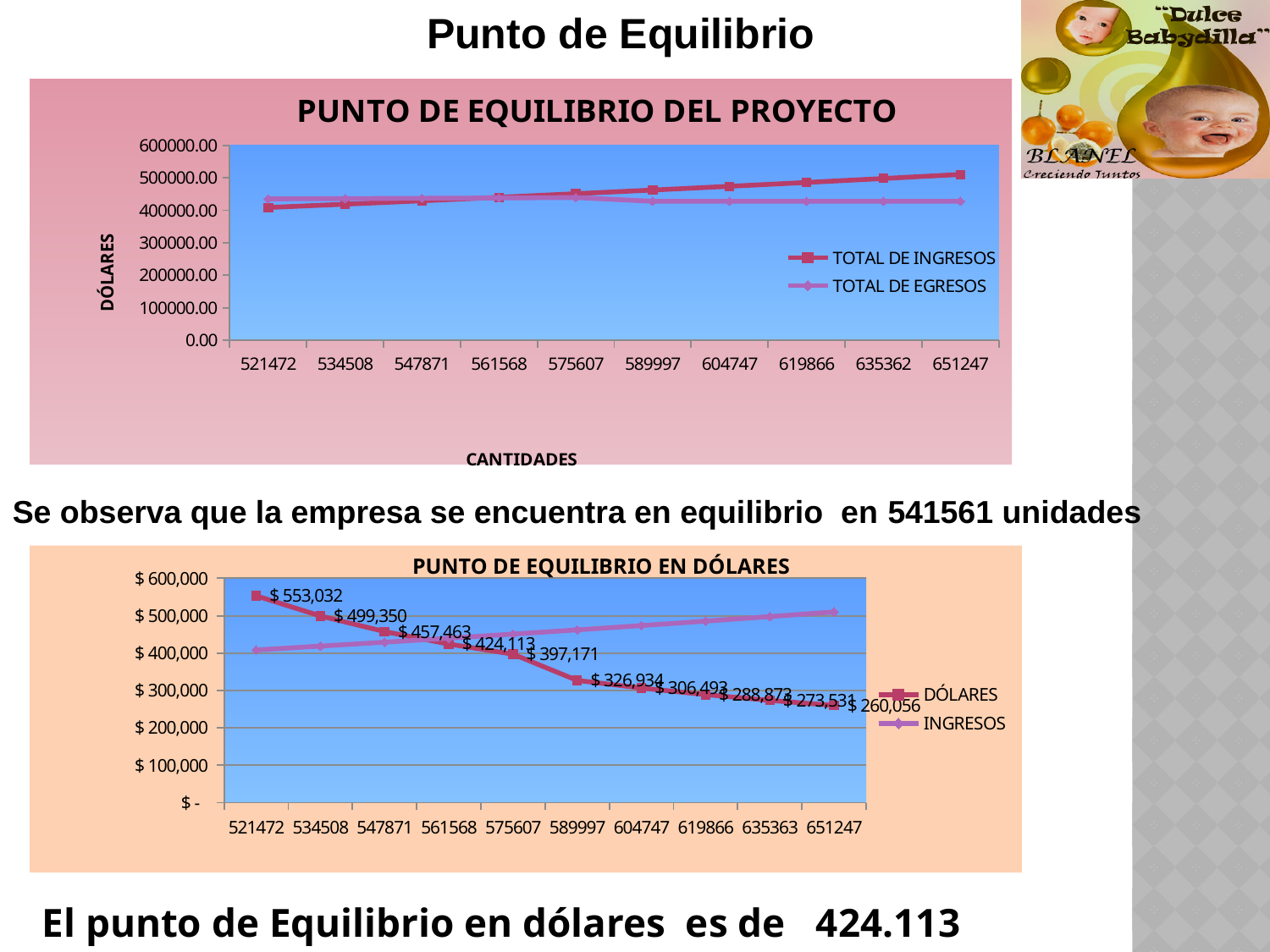
In the chart titled 'PUNTO DE EQUILIBRIO EN DÓLARES', does the DÓLARES series rise or fall along the x axis? Fall In the chart titled 'PUNTO DE EQUILIBRIO DEL PROYECTO', is the TOTAL DE INGRESOS value at 651247 greater or less than 400000.00? greater In the chart titled 'PUNTO DE EQUILIBRIO DEL PROYECTO', how many series does the legend list? 2 In the chart titled 'PUNTO DE EQUILIBRIO DEL PROYECTO', what is the label of the y axis? DÓLARES In the chart titled 'PUNTO DE EQUILIBRIO DEL PROYECTO', how many categories are shown on the x axis? 10 In the chart titled 'PUNTO DE EQUILIBRIO EN DÓLARES', what is the difference between the DÓLARES values at 521472 and 534508? $ 53,682 In the chart titled 'PUNTO DE EQUILIBRIO EN DÓLARES', what is the DÓLARES value at 561568? $ 424,113 In the chart titled 'PUNTO DE EQUILIBRIO EN DÓLARES', what is the DÓLARES value at 521472? $ 553,032 In the chart titled 'PUNTO DE EQUILIBRIO EN DÓLARES', which category has the lowest DÓLARES value? 651247 In the chart titled 'PUNTO DE EQUILIBRIO EN DÓLARES', which is larger: the DÓLARES value at 575607 or at 589997? 575607 In the chart titled 'PUNTO DE EQUILIBRIO DEL PROYECTO', does the TOTAL DE INGRESOS series rise or fall along the x axis? Rise In the chart titled 'PUNTO DE EQUILIBRIO DEL PROYECTO', what kind of chart is shown? Line chart